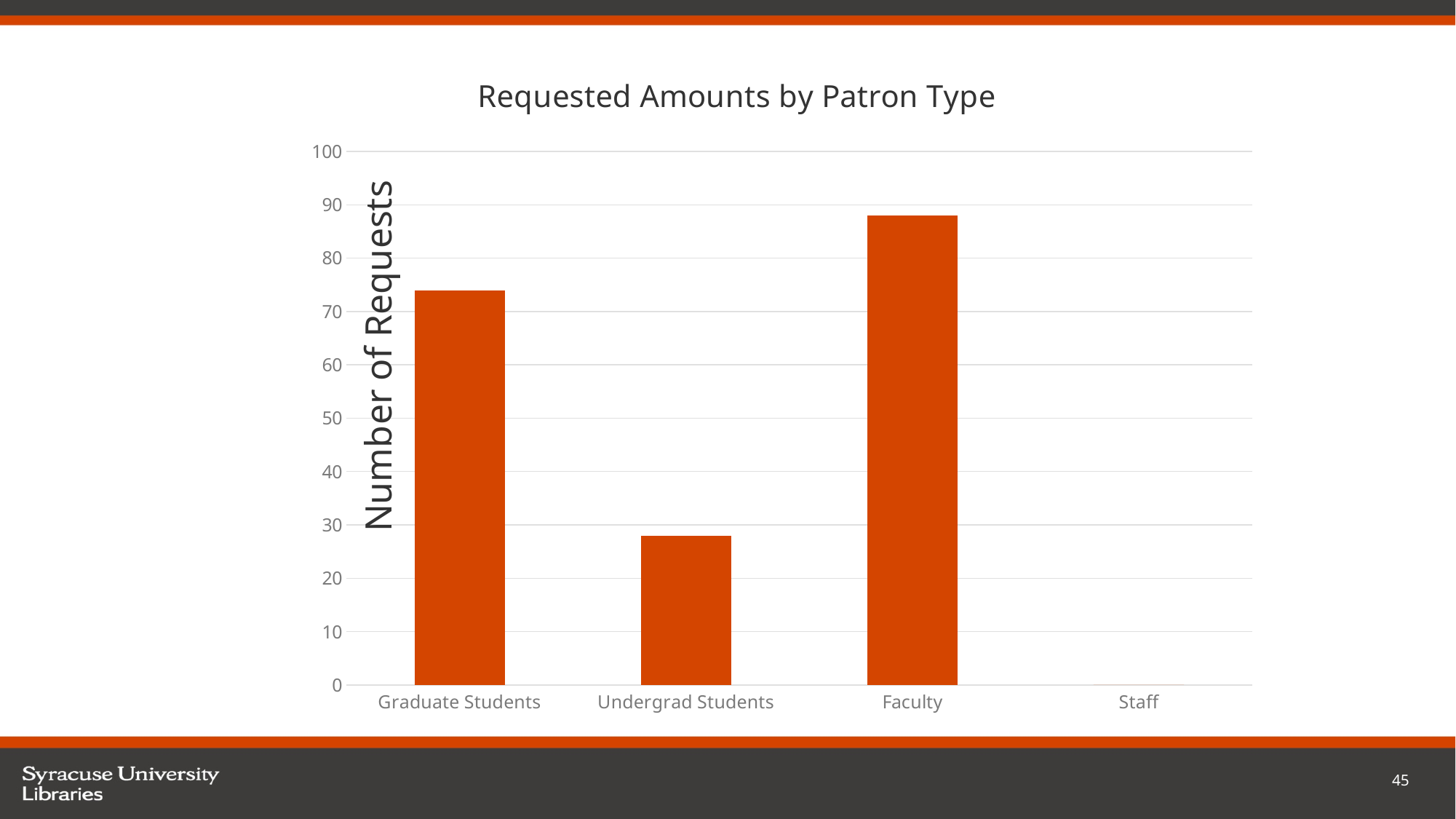
Which patron type has the lowest number of requests? Staff Which has more requests, Faculty or Graduate Students? Faculty What kind of chart is shown on the slide? bar chart Is the value for Undergrad Students greater or less than 30? less Is the value for Staff greater or less than 10? less Is the value for Faculty greater or less than 80? greater Which patron type has the highest number of requests? Faculty What is the label on the vertical axis of the chart? Number of Requests What is the title of the chart? Requested Amounts by Patron Type How many patron type categories are shown on the x axis? 4 Which has more requests, Graduate Students or Undergrad Students? Graduate Students